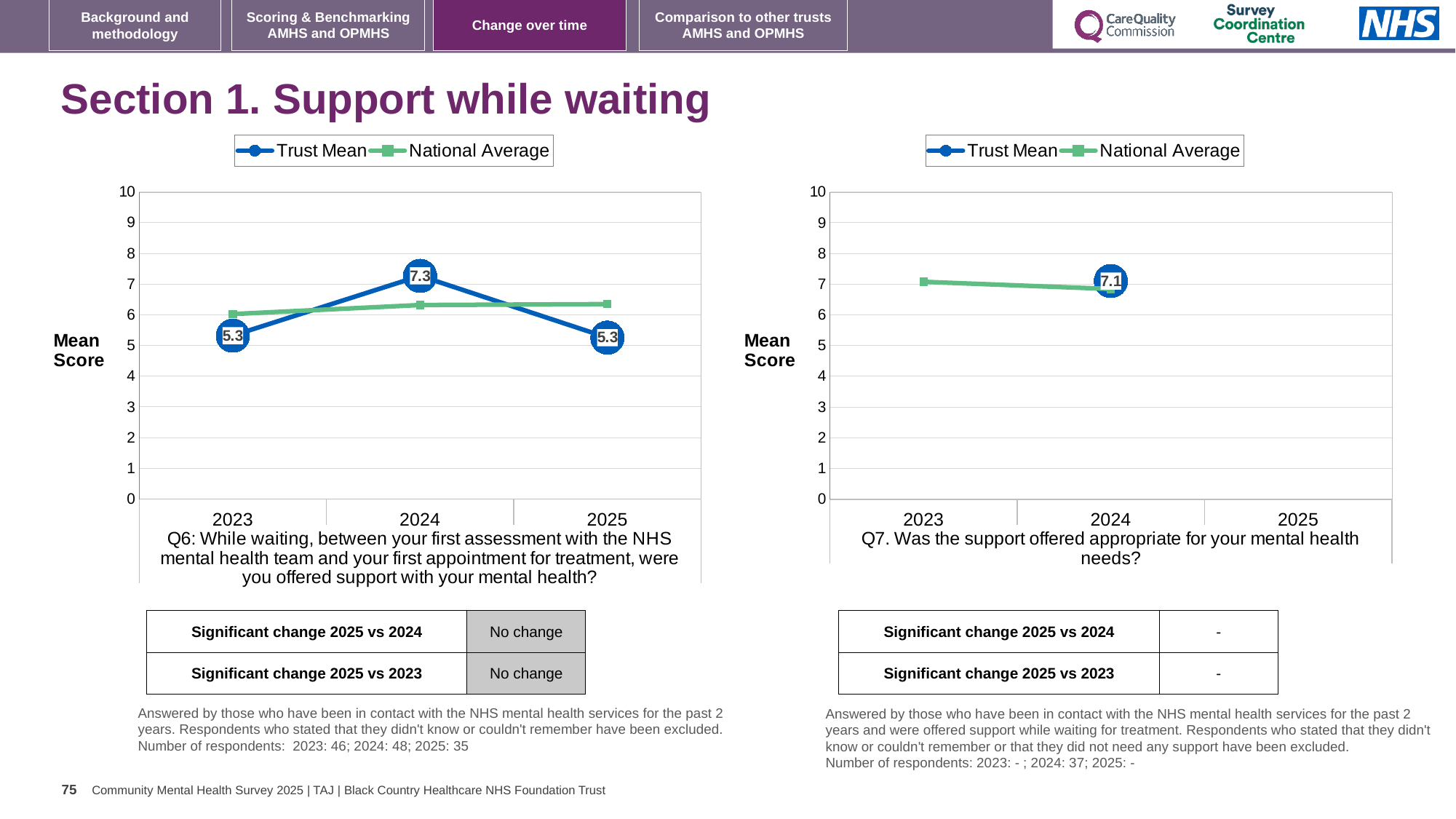
On the left chart (Q6), what is the Trust Mean score for 2023? 5.3 On the left chart (Q6), is the Trust Mean for 2023 greater or less than the National Average for 2023? less On the right chart (Q7), what is the Trust Mean score for 2024? 7.1 On the left chart (Q6), what is the difference between the Trust Mean in 2024 and in 2025? 2.0 How many series does the legend of the left chart (Q6) list? 2 On the left chart (Q6), does the Trust Mean rise or fall from 2024 to 2025? Fall On the left chart (Q6), what is the Trust Mean score for 2025? 5.3 On the left chart (Q6), in which year is the Trust Mean highest? 2024 On the right chart (Q7), is the National Average for 2023 greater or less than 6? greater What kind of chart is the right chart (Q7)? Line chart On the left chart (Q6), what is the Trust Mean score for 2024? 7.3 On the left chart (Q6), is the National Average for 2025 greater or less than 6? greater